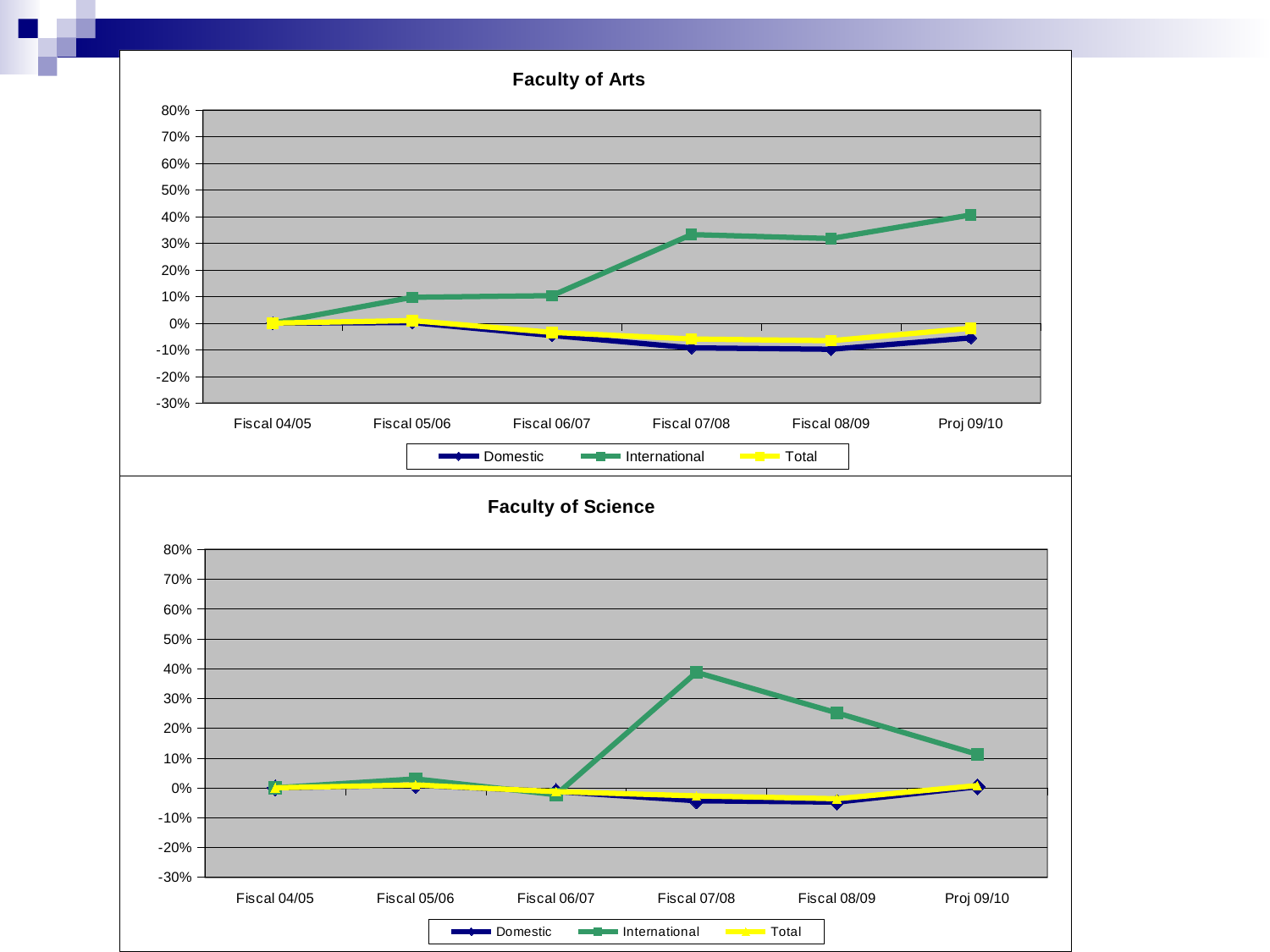
In the Faculty of Science chart, does the International series rise or fall from Fiscal 07/08 to Proj 09/10? fall How many fiscal periods are shown on the x axis of the Faculty of Arts chart? 6 How many series does the legend of the Faculty of Science chart list? 3 In the Faculty of Arts chart, does the International series generally rise or fall from Fiscal 04/05 to Proj 09/10? rise In the Faculty of Arts chart, is the International value for Fiscal 07/08 greater or less than 30%? greater In the Faculty of Arts chart, which is larger at Fiscal 07/08: the International value or the Domestic value? International In the Faculty of Arts chart, which fiscal period has the highest International value? Proj 09/10 In the Faculty of Science chart, is the International value for Proj 09/10 greater or less than 20%? less In the Faculty of Science chart, is the International value for Fiscal 08/09 greater or less than 20%? greater In the Faculty of Science chart, which fiscal period has the highest International value? Fiscal 07/08 What is the title of the lower chart on the slide? Faculty of Science What kind of chart is the Faculty of Arts chart? line chart